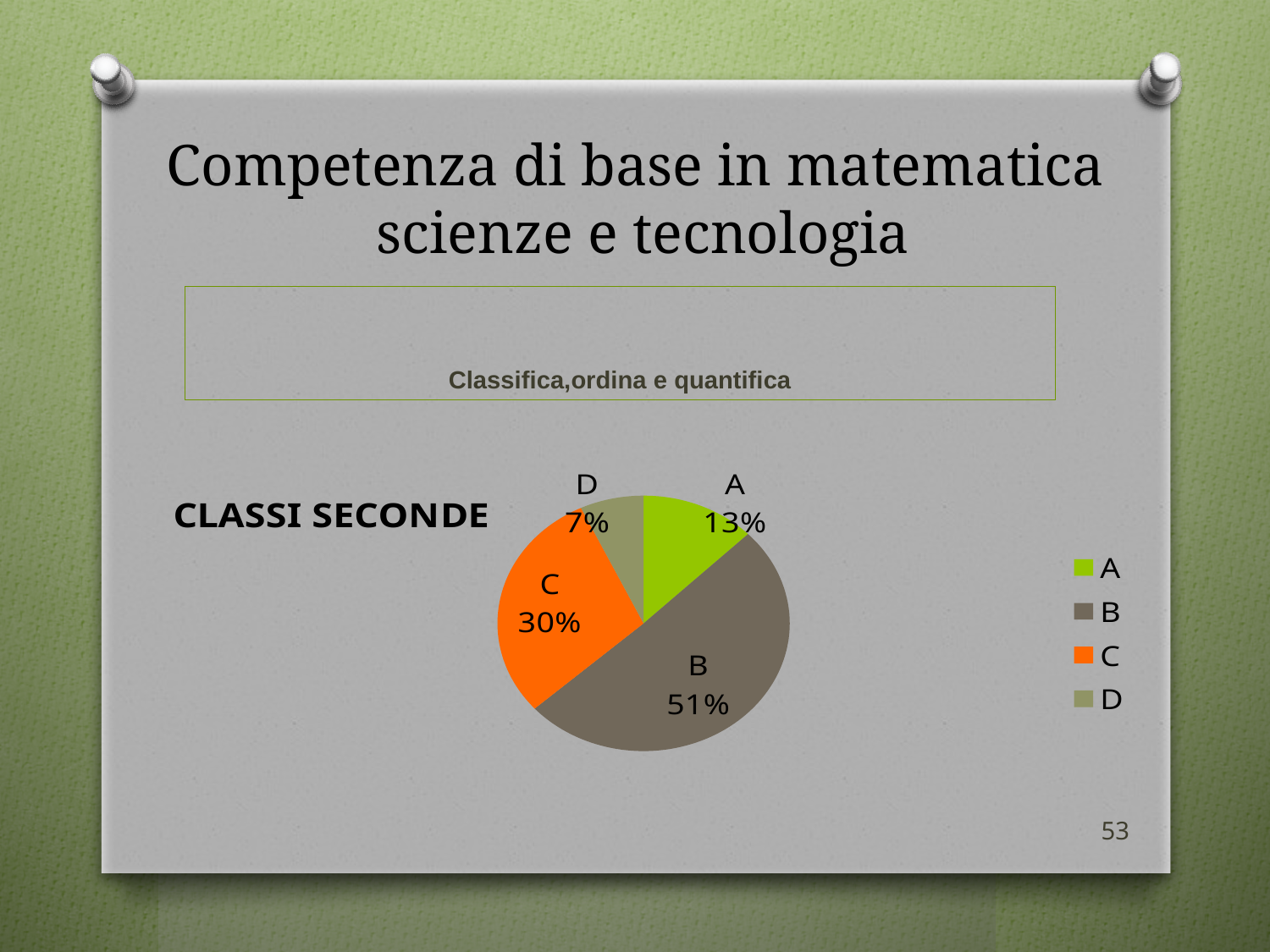
What percentage does slice B represent? 51% How many entries does the legend list? 4 What kind of chart is shown on the slide? pie chart Which category has the smallest share of the pie? D Which category has the largest share of the pie? B How many slices does the pie chart have? 4 What percentage does slice C represent? 30% What percentage does slice A represent? 13% What colour is the slice for C? orange What is the difference in percentage points between B and C? 21 What percentage does slice D represent? 7% Which is larger, the share for A or the share for D? A